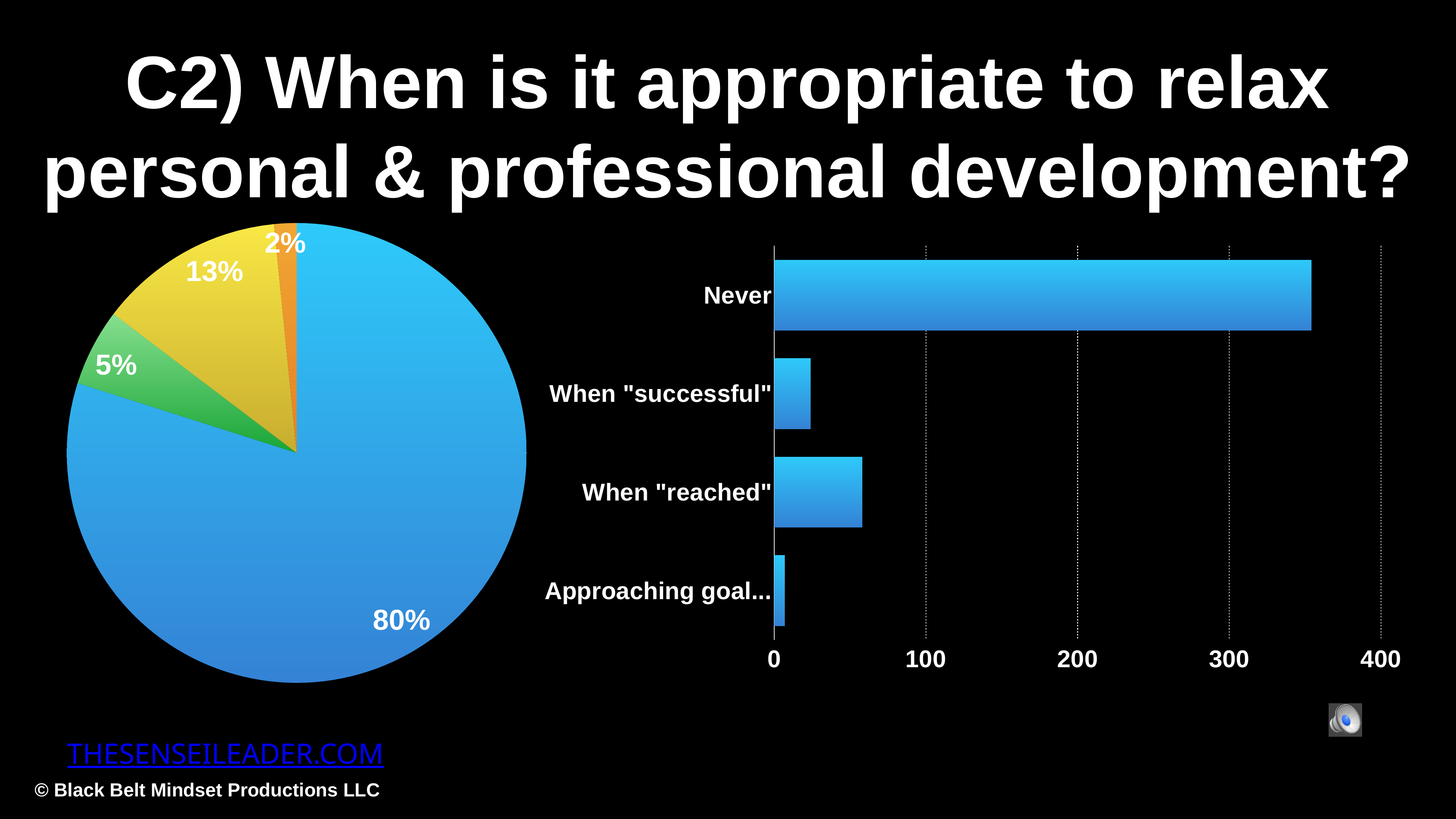
In the pie chart on the left, what is the share of the yellow slice? 13% In the pie chart on the left, what is the share of the smallest slice? 2% What type of chart is on the right side of the slide? bar chart In the bar chart on the right, is the value for When "reached" greater or less than 100? less In the bar chart on the right, which category has the highest value? Never What type of chart is on the left side of the slide? pie chart In the pie chart on the left, what is the share of the largest slice? 80% In the bar chart on the right, is the value for Never greater or less than 300? greater In the pie chart on the left, what is the share of the green slice? 5% In the bar chart on the right, which is larger: When "reached" or When "successful"? When "reached" How many slices does the pie chart on the left have? 4 In the bar chart on the right, which category has the lowest value? Approaching goal...